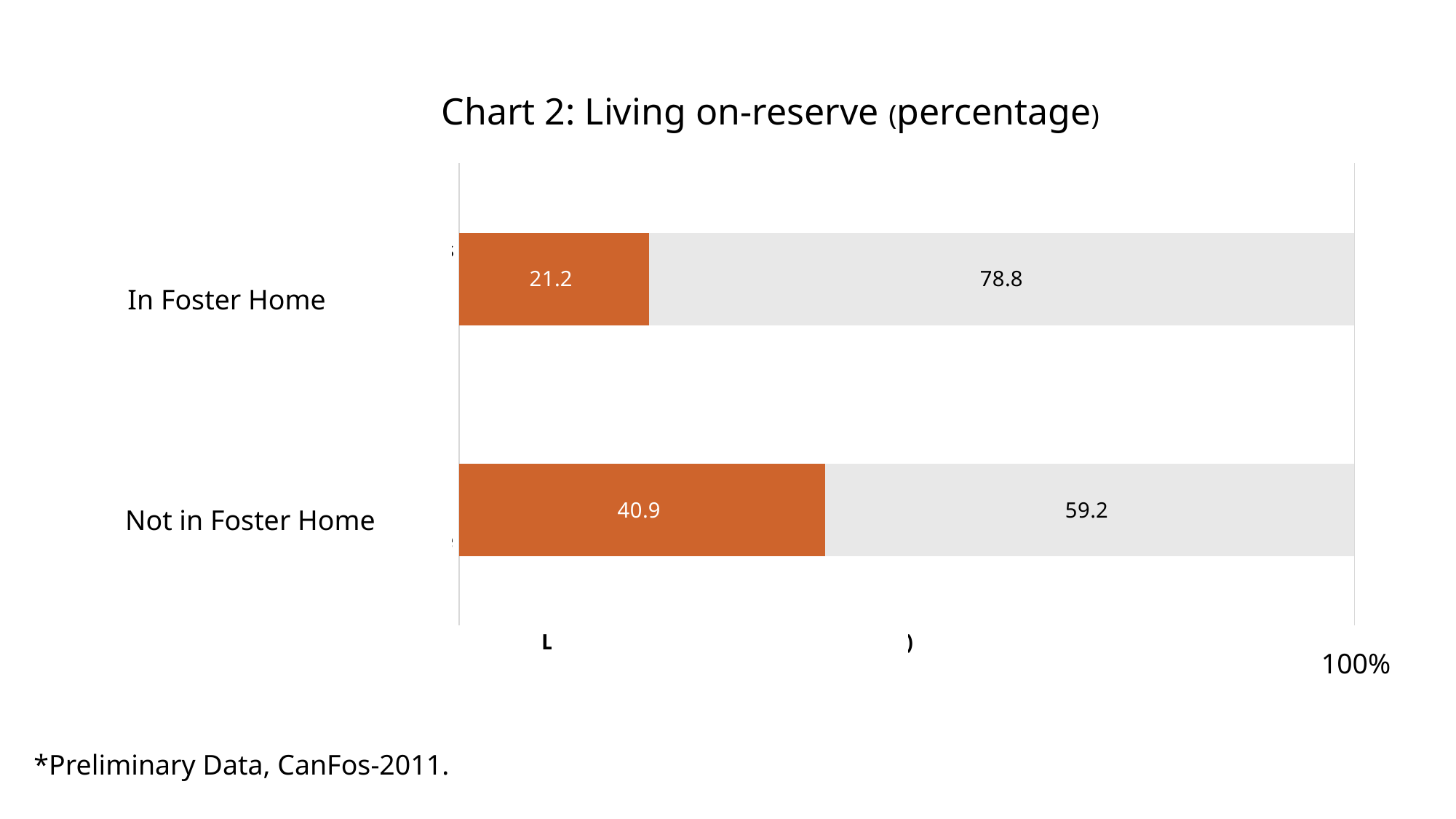
What is the total of the stacked bar for In Foster Home? 100 Which category has the smaller grey segment? Not in Foster Home What is the difference between the grey segment values for In Foster Home and Not in Foster Home? 19.6 What is the difference between the orange segment values for Not in Foster Home and In Foster Home? 19.7 What is the value of the orange segment for Not in Foster Home? 40.9 What is the value of the grey segment for Not in Foster Home? 59.2 What is the value of the orange segment for In Foster Home? 21.2 How many categories are shown on the chart? 2 What kind of chart is shown on the slide? Stacked bar chart Which category has the larger orange segment, In Foster Home or Not in Foster Home? Not in Foster Home What is the value of the grey segment for In Foster Home? 78.8 What is the title of the chart? Chart 2: Living on-reserve (percentage)